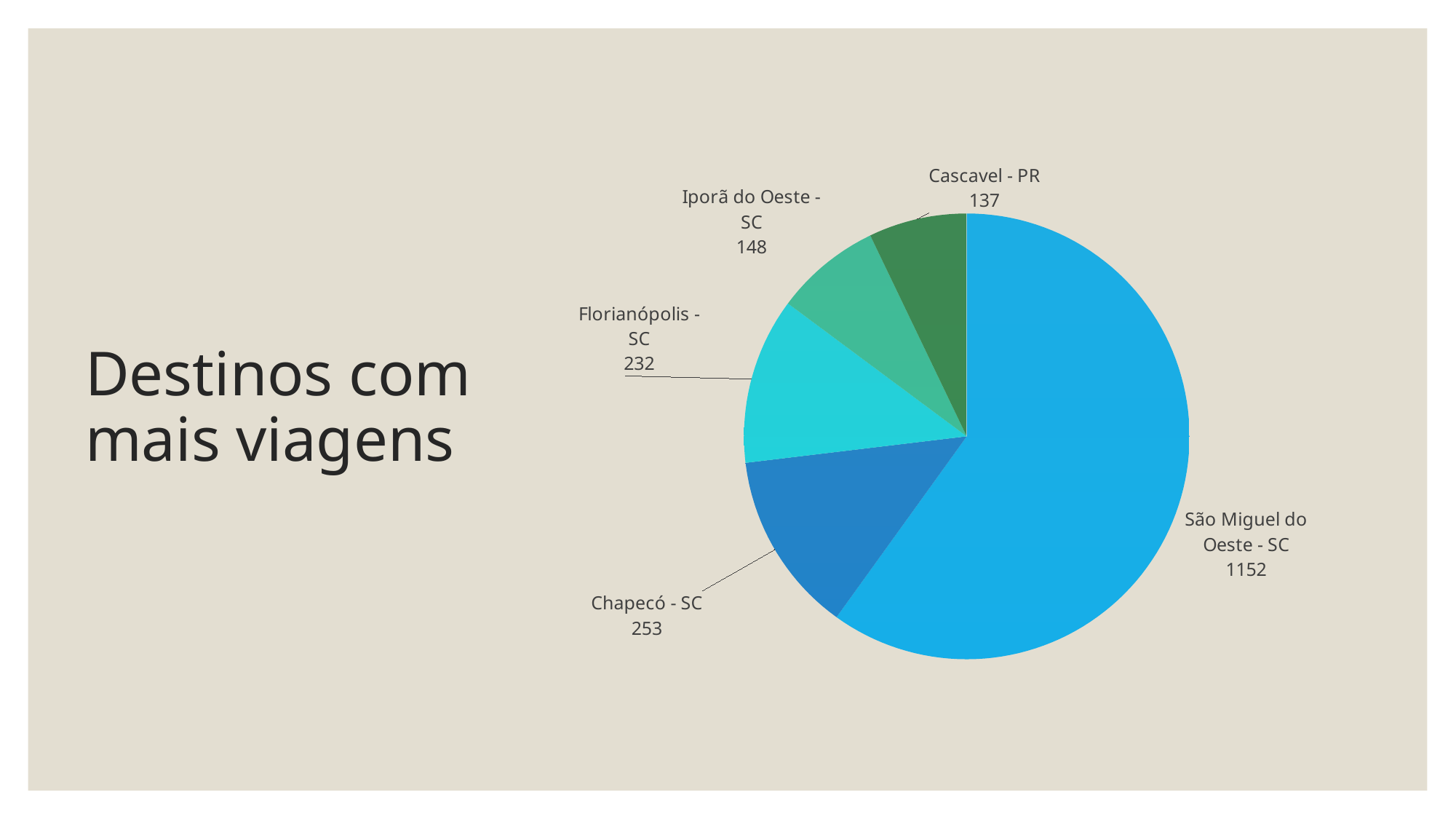
What is the total of all the values in the pie chart? 1922 How many slices does the pie chart have? 5 Which destination has the highest number of trips? São Miguel do Oeste - SC What is the value for Cascavel - PR? 137 What is the difference between the values for Chapecó - SC and Florianópolis - SC? 21 Which destination has the lowest number of trips? Cascavel - PR Which has a larger value, Iporã do Oeste - SC or Cascavel - PR? Iporã do Oeste - SC What type of chart is shown on the slide? pie chart What is the difference between the values for São Miguel do Oeste - SC and Cascavel - PR? 1015 What is the title of the chart? Destinos com mais viagens What is the value for Florianópolis - SC? 232 What is the value for São Miguel do Oeste - SC? 1152